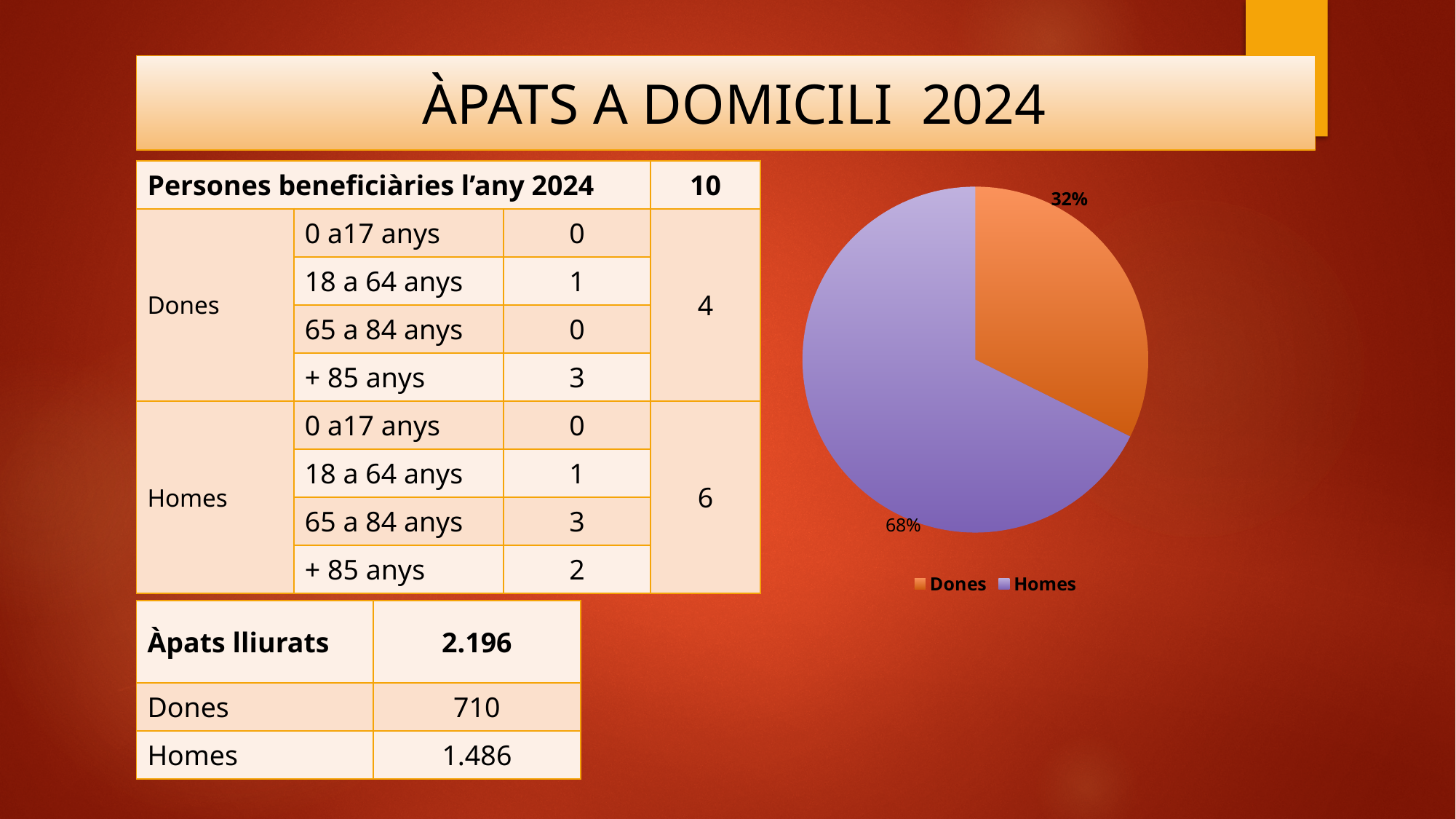
Which is larger in the pie chart, Dones or Homes? Homes What kind of chart is shown on the slide? pie chart How many entries does the pie chart legend list? 2 How many slices does the pie chart have? 2 What colour is the Homes slice in the pie chart? purple What share of the pie chart does Dones represent? 32% What is the difference in percentage points between the Homes and Dones slices of the pie chart? 36 What share of the pie chart does Homes represent? 68% Is the share for Homes in the pie chart greater or less than 50%? greater What are the two legend entries of the pie chart? Dones and Homes Which slice of the pie chart is the smallest? Dones Which slice of the pie chart is the largest? Homes